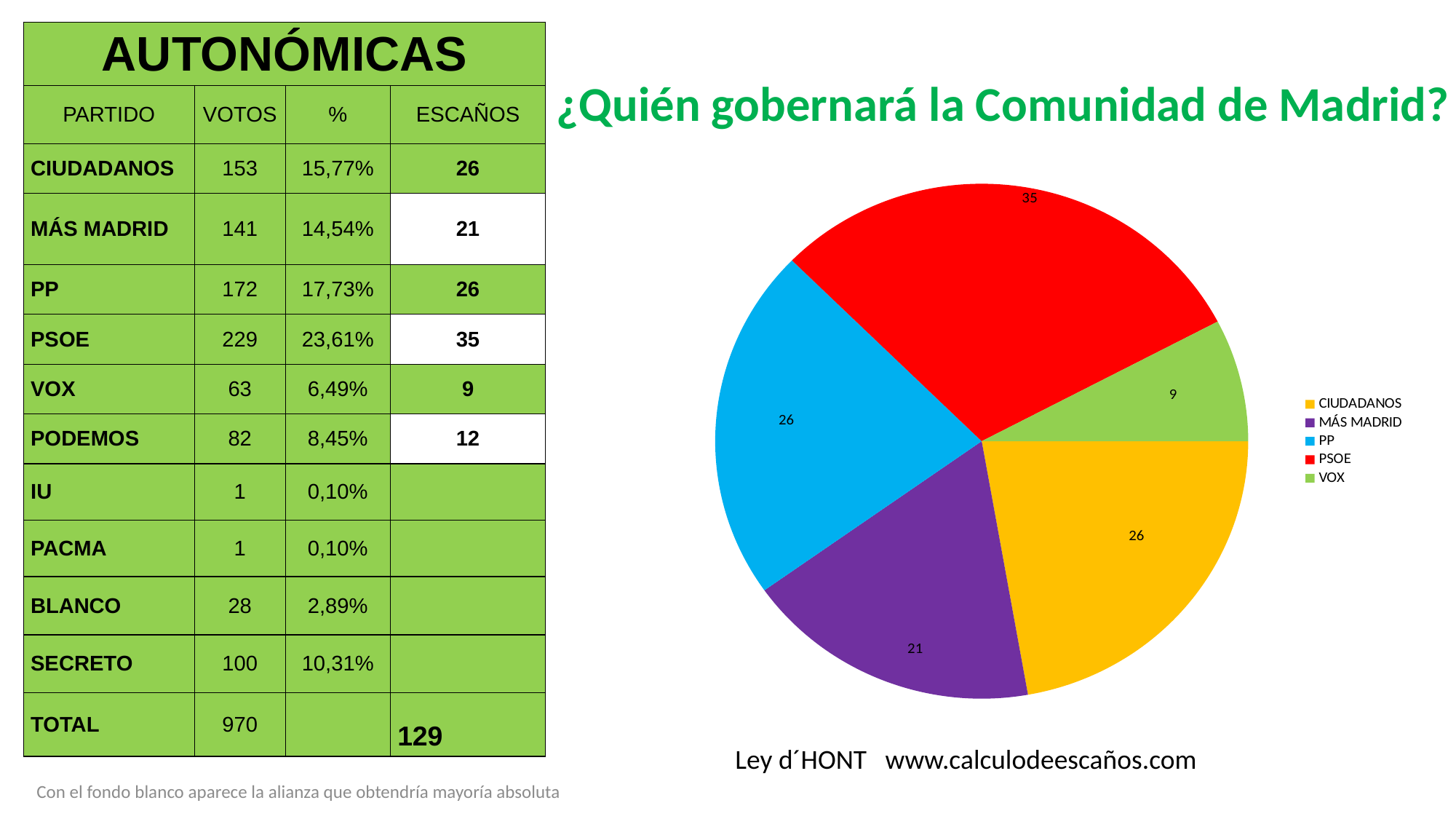
What is the difference between the PSOE and VOX values in the pie chart? 26 What type of chart is shown on the slide? pie chart What value is shown for PP in the pie chart? 26 What value is shown for MÁS MADRID in the pie chart? 21 How many entries does the pie chart's legend list? 5 What colour is the PSOE slice in the pie chart? red What value is shown for PSOE in the pie chart? 35 Which party has the smallest slice in the pie chart? VOX Which party has the largest slice in the pie chart? PSOE How many slices does the pie chart have? 5 What value is shown for VOX in the pie chart? 9 In the pie chart, which is larger, the value for PSOE or the value for MÁS MADRID? PSOE